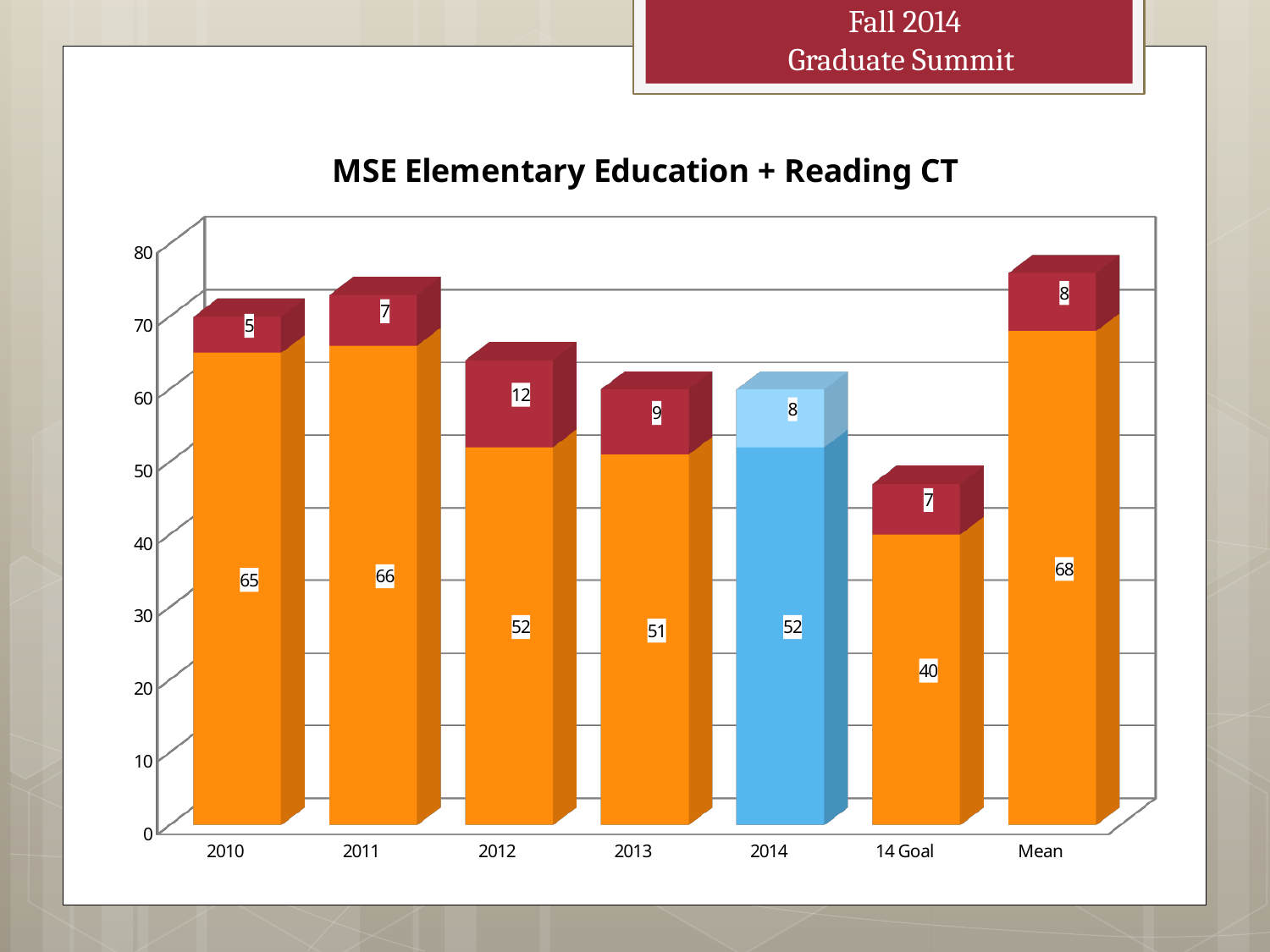
What is the total of the stacked bar for 2011? 73 What is the value of the top segment of the bar for Mean? 8 Is the top-segment value larger for 2012 or for 2013? 2012 What is the title of the chart? MSE Elementary Education + Reading CT What is the value of the top segment of the bar for 2012? 12 What is the total of the stacked bar for 14 Goal? 47 Which category has the lowest bottom-segment value? 14 Goal Which category has the highest bottom-segment value? Mean How many categories are shown on the x axis? 7 What is the value of the bottom segment of the bar for 14 Goal? 40 What is the difference between the bottom-segment values for 2011 and 2013? 15 What is the value of the bottom segment of the bar for 2010? 65